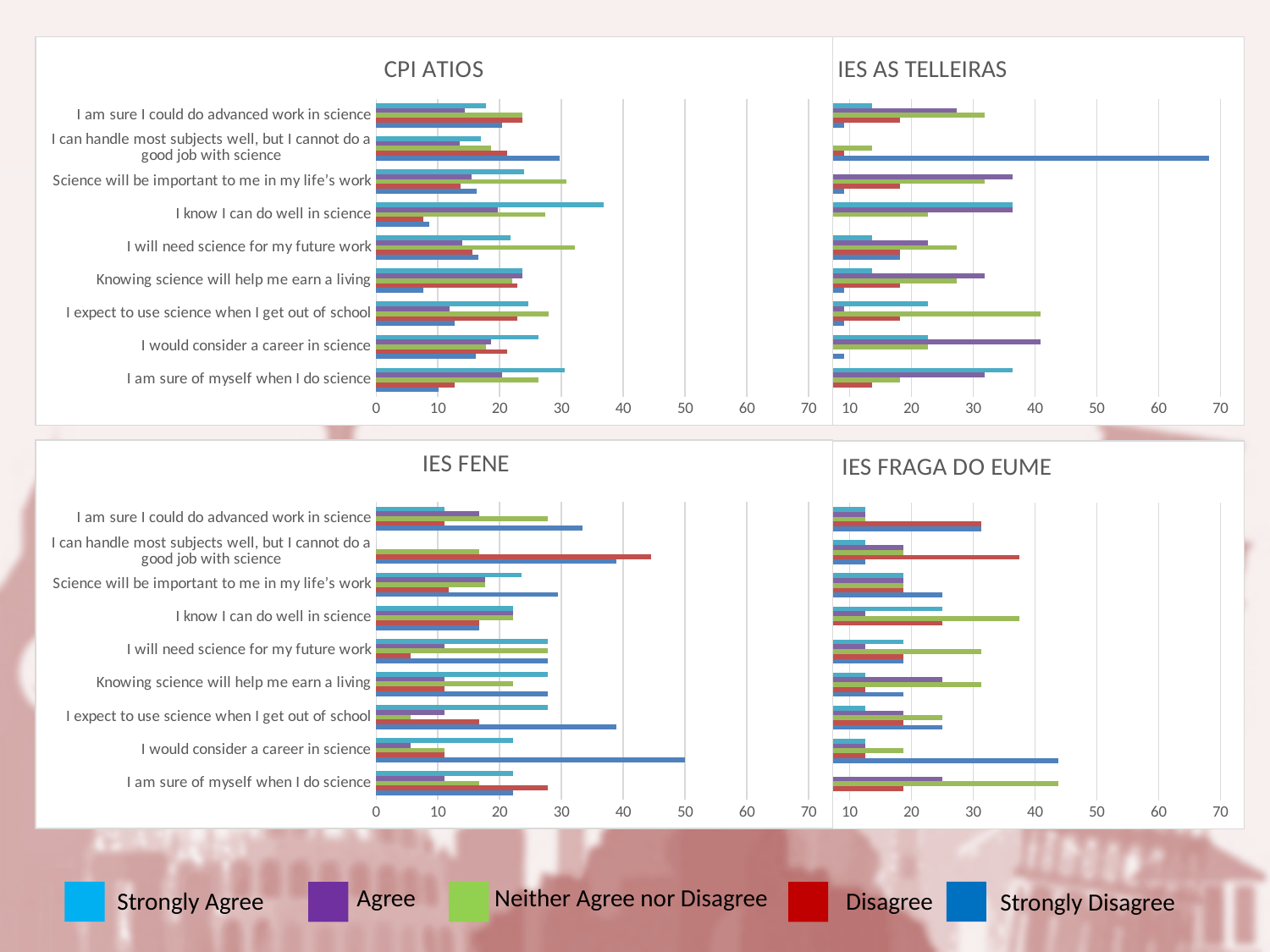
How many statement categories are plotted in the IES FENE chart? 9 In the CPI ATIOS chart, is the Strongly Agree value for 'I know I can do well in science' greater or less than 30? greater In the CPI ATIOS chart, for 'I know I can do well in science', which is larger: the Strongly Agree value or the Strongly Disagree value? Strongly Agree In the IES AS TELLEIRAS chart, which statement has the single longest bar? I can handle most subjects well, but I cannot do a good job with science In the IES FRAGA DO EUME chart, is the Neither Agree nor Disagree value for 'I am sure of myself when I do science' greater or less than 40? greater Which colour does the legend use for the Disagree series? red What kind of chart is the CPI ATIOS chart? bar chart In the IES AS TELLEIRAS chart, is the Strongly Disagree value for 'I can handle most subjects well, but I cannot do a good job with science' greater or less than 60? greater How many series does the legend at the bottom of the slide list? 5 In the IES FENE chart, which statement has the single longest bar? I would consider a career in science